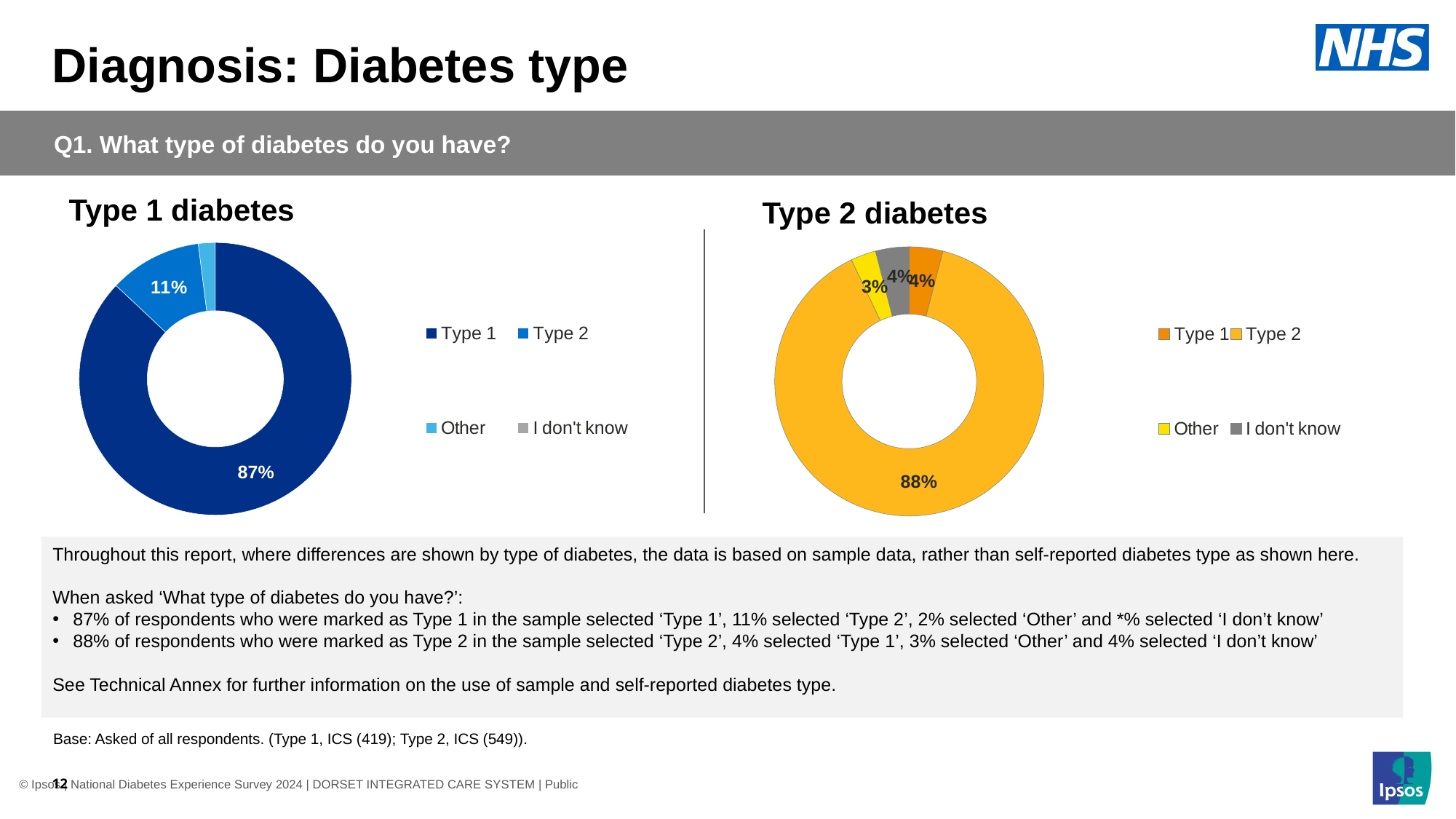
In the Type 2 diabetes chart, which category has the largest share? Type 2 In the Type 1 diabetes chart, what is the difference in percentage points between the 'Type 1' and 'Type 2' shares? 76 percentage points Which is larger: the 'Type 2' share in the Type 1 diabetes chart or the 'Other' share in the Type 2 diabetes chart? The 'Type 2' share in the Type 1 diabetes chart (11%) In the Type 2 diabetes chart, what percentage of respondents selected 'Other'? 3% In the Type 1 diabetes chart, what percentage of respondents selected 'Type 2'? 11% What kind of chart is used to show the Type 1 diabetes results? Doughnut (pie) chart How many categories does the legend of the Type 2 diabetes chart list? 4 In the Type 1 diabetes chart, what percentage of respondents selected 'Type 1'? 87% In the Type 2 diabetes chart, what percentage of respondents selected 'I don't know'? 4% In the Type 2 diabetes chart, what percentage of respondents selected 'Type 2'? 88% In the Type 1 diabetes chart, which category has the largest share? Type 1 In the Type 2 diabetes chart, what is the difference in percentage points between the 'Type 2' and 'Other' shares? 85 percentage points